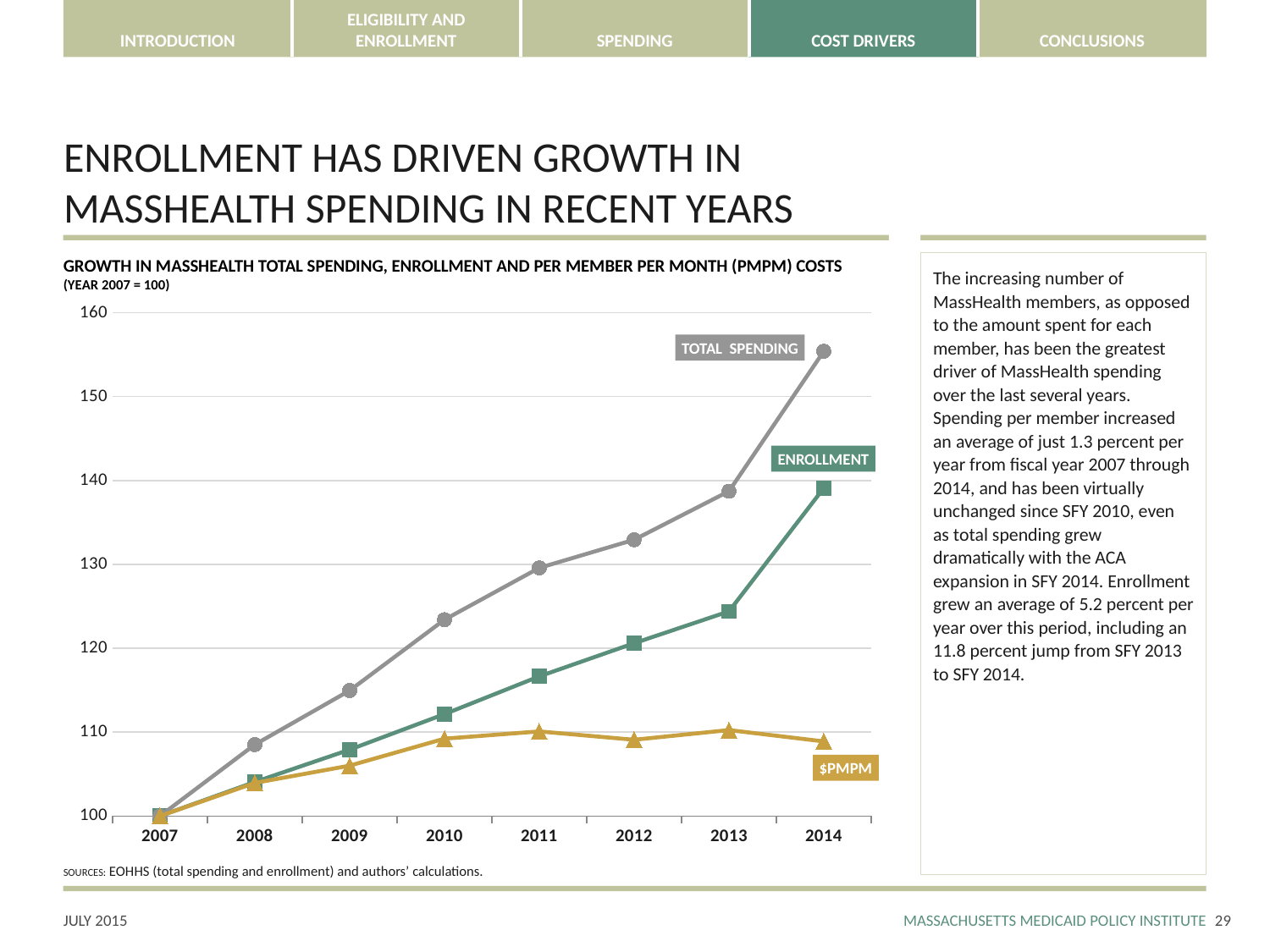
What is the index value for Total Spending in 2007? 100 How many years are shown on the x axis of the chart? 8 How many series are plotted on the chart? 3 Which series has the lowest value in 2014? $PMPM Which year is used as the base year (= 100) for the index in the chart? 2007 Does the Total Spending series rise or fall from 2007 to 2014? Rises Which series has the highest value in 2014? Total Spending Is the value for Total Spending in 2014 greater or less than 150? greater What kind of chart is shown on the slide? Line chart In 2012, which is larger: Enrollment or $PMPM? Enrollment Is the value for $PMPM in 2014 greater or less than 120? less Is the value for Enrollment in 2011 greater or less than 120? less